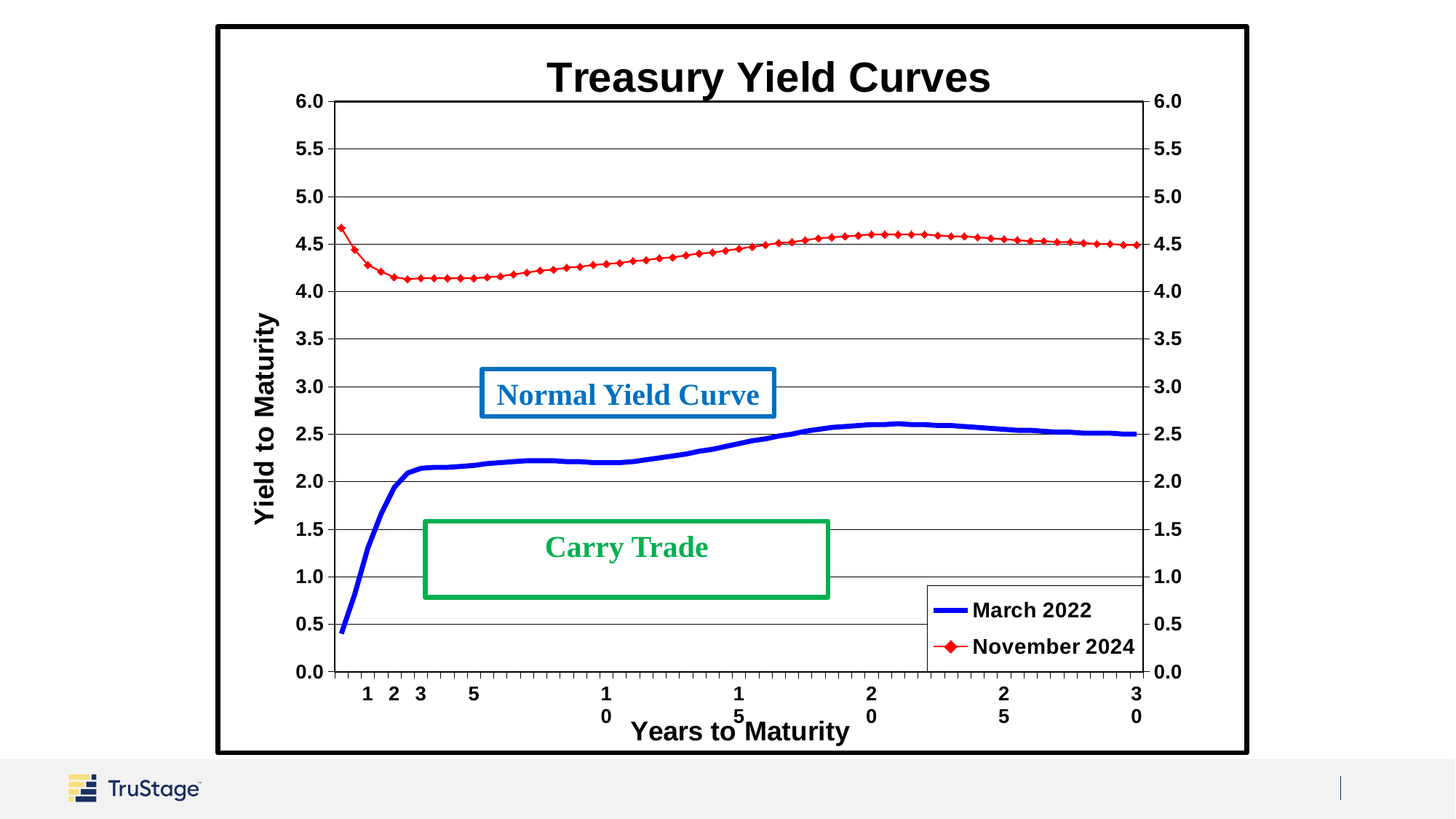
Is the November 2024 yield at 5 years to maturity greater or less than 4.0? greater Is the November 2024 yield at 20 years to maturity greater or less than 5.0? less Which series is lower across all maturities shown? March 2022 At 10 years to maturity, which series has the higher yield, March 2022 or November 2024? November 2024 Does the November 2024 curve rise or fall between the shortest maturity and 3 years to maturity? fall How many series does the legend list? 2 Does the March 2022 curve rise or fall between 1 and 5 years to maturity? rise Is the March 2022 yield at the shortest maturity shown greater or less than 1.0? less Which series is drawn in red with diamond markers? November 2024 What kind of chart is shown on the slide? Line chart What is the title of the chart? Treasury Yield Curves